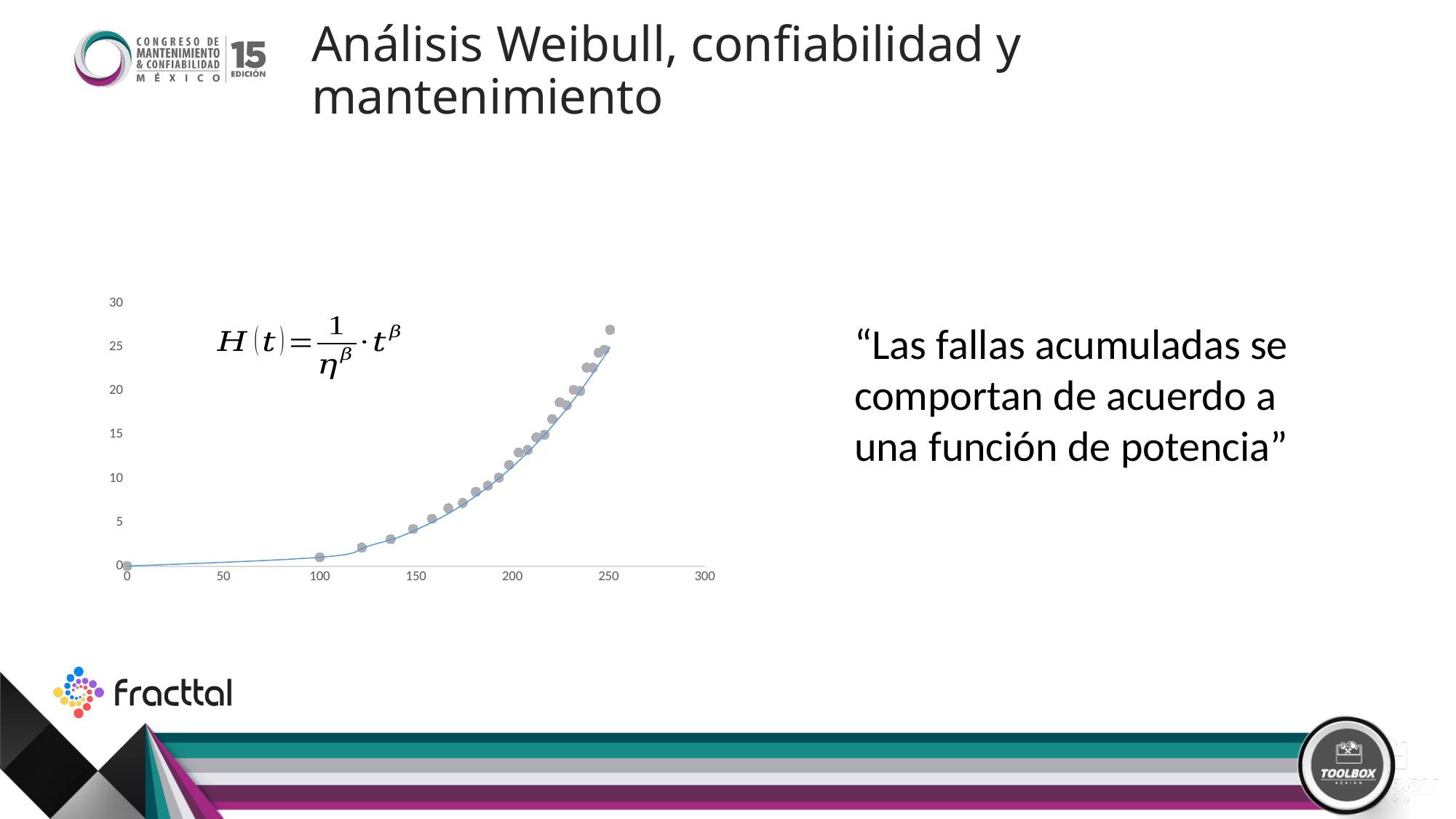
What is the highest tick value shown on the x-axis? 300 What is the highest tick value shown on the y-axis? 30 Is the plotted value at x = 225 greater or less than 15? greater Is the plotted value at x = 100 greater or less than 5? less Is the plotted value at x = 200 greater or less than 10? greater Do the plotted values rise or fall as the x-axis value increases? rise Which plotted point has the highest value, the one at x = 250 or the one at x = 100? x = 250 What kind of chart is shown on the slide? scatter chart